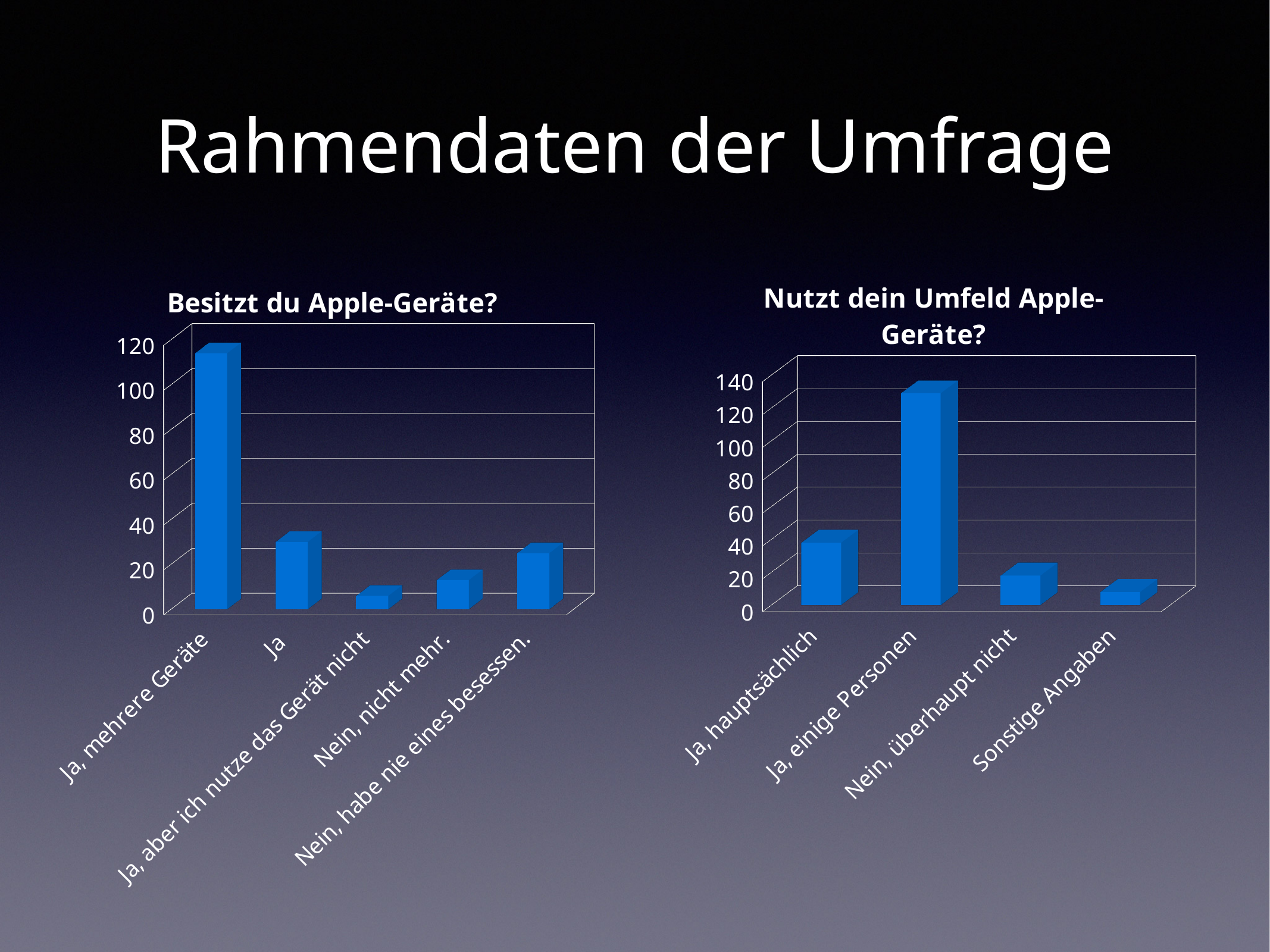
In the chart 'Besitzt du Apple-Geräte?', is the value for 'Ja' greater or less than 40? less In the chart 'Nutzt dein Umfeld Apple-Geräte?', is the value for 'Ja, hauptsächlich' greater or less than 60? less In the chart 'Nutzt dein Umfeld Apple-Geräte?', which is larger: the value for 'Ja, hauptsächlich' or the value for 'Nein, überhaupt nicht'? Ja, hauptsächlich In the chart 'Nutzt dein Umfeld Apple-Geräte?', which category has the highest value? Ja, einige Personen In the chart 'Besitzt du Apple-Geräte?', which category has the highest value? Ja, mehrere Geräte In the chart 'Nutzt dein Umfeld Apple-Geräte?', is the value for 'Ja, einige Personen' greater or less than 120? greater In the chart 'Besitzt du Apple-Geräte?', which is larger: the value for 'Ja' or the value for 'Nein, nicht mehr.'? Ja What kind of chart is the chart on the right of the slide? Bar chart In the chart 'Besitzt du Apple-Geräte?', which category has the lowest value? Ja, aber ich nutze das Gerät nicht In the chart 'Nutzt dein Umfeld Apple-Geräte?', which category has the lowest value? Sonstige Angaben How many categories are shown in the chart 'Besitzt du Apple-Geräte?'? 5